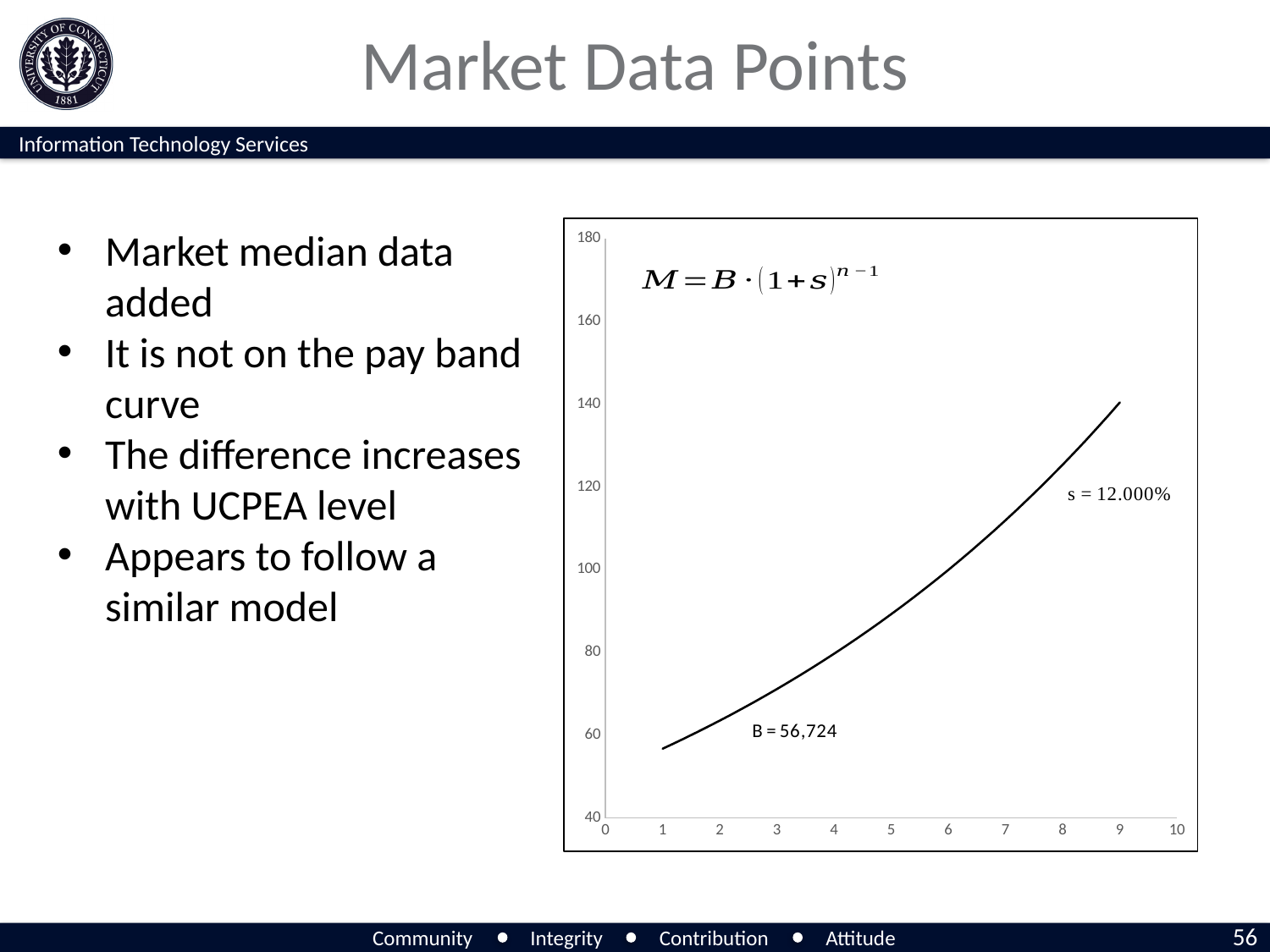
What kind of chart is shown on the slide? line chart Is the value of the curve at x = 5 greater or less than 100? less Do the values on the curve rise or fall as x increases from 1 to 9? rise Is the value of the curve at x = 9 greater or less than 120? greater Is the value of the curve at x = 1 greater or less than 80? less What value of B is annotated on the chart? 56,724 At which x value is the curve at its lowest point? 1 At which x value does the curve reach its highest point? 9 What value of s is annotated on the chart? 12.000% Which is larger, the value of the curve at x = 9 or at x = 1? x = 9